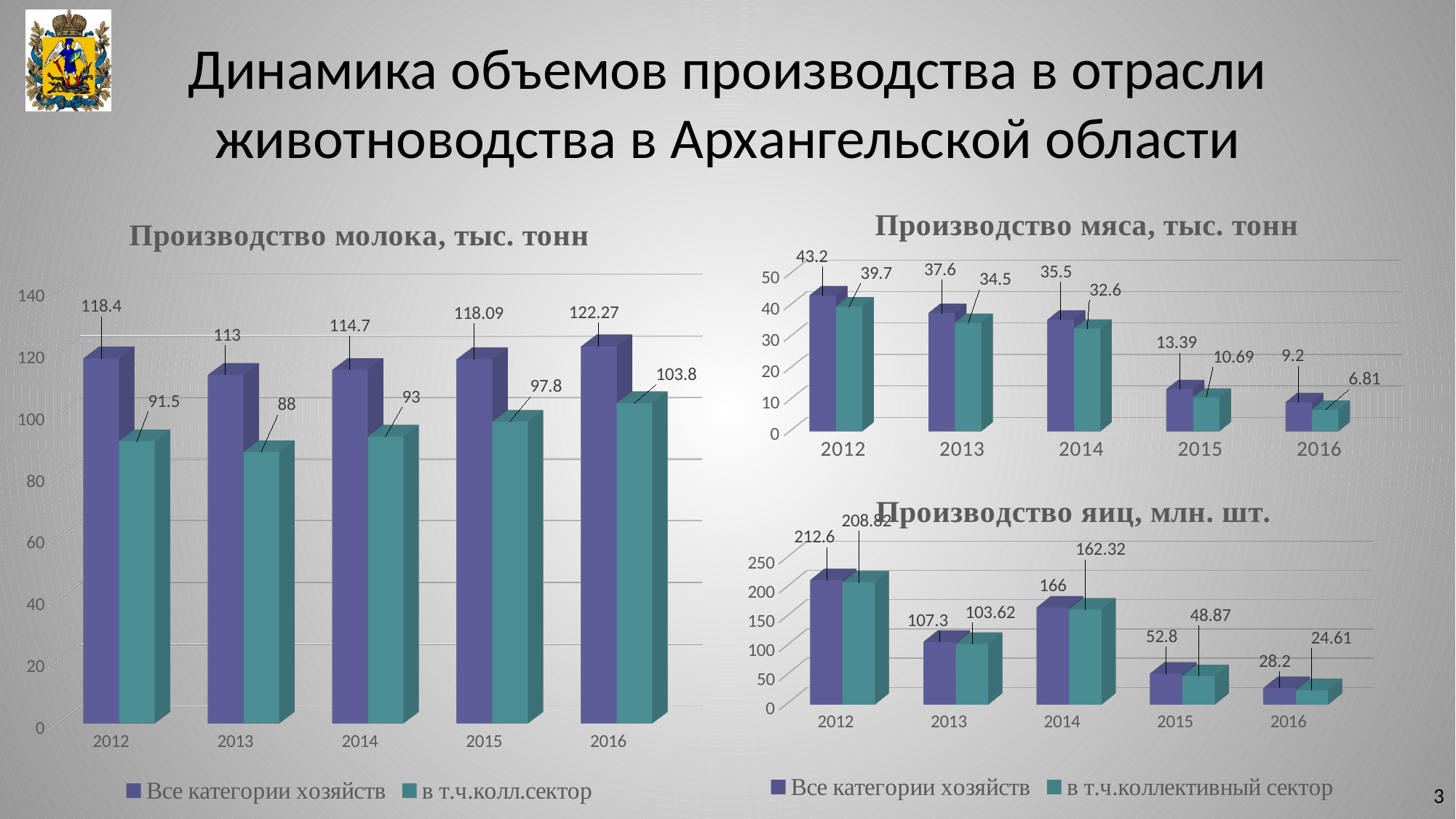
In the chart 'Производство молока, тыс. тонн', what is the value for 'Все категории хозяйств' in 2016? 122.27 In the chart 'Производство мяса, тыс. тонн', do the values for 'Все категории хозяйств' rise or fall from 2012 to 2016? fall In the chart 'Производство яиц, млн. шт.', which is larger: 'Все категории хозяйств' in 2013 or in 2014? 2014 How many years are shown on the x axis of the chart 'Производство молока, тыс. тонн'? 5 In the chart 'Производство молока, тыс. тонн', which year has the lowest value for 'Все категории хозяйств'? 2013 In the chart 'Производство молока, тыс. тонн', what is the difference between 'Все категории хозяйств' and 'в т.ч.колл.сектор' in 2012? 26.9 In the chart 'Производство мяса, тыс. тонн', which year has the highest value for 'в т.ч.коллективный сектор'? 2012 In the chart 'Производство молока, тыс. тонн', what is the value for 'в т.ч.колл.сектор' in 2013? 88 In the chart 'Производство мяса, тыс. тонн', what is the value for 'Все категории хозяйств' in 2015? 13.39 In the chart 'Производство яиц, млн. шт.', what is the value for 'в т.ч.коллективный сектор' in 2014? 162.32 In the chart 'Производство яиц, млн. шт.', what is the difference between 'Все категории хозяйств' and 'в т.ч.коллективный сектор' in 2016? 3.59